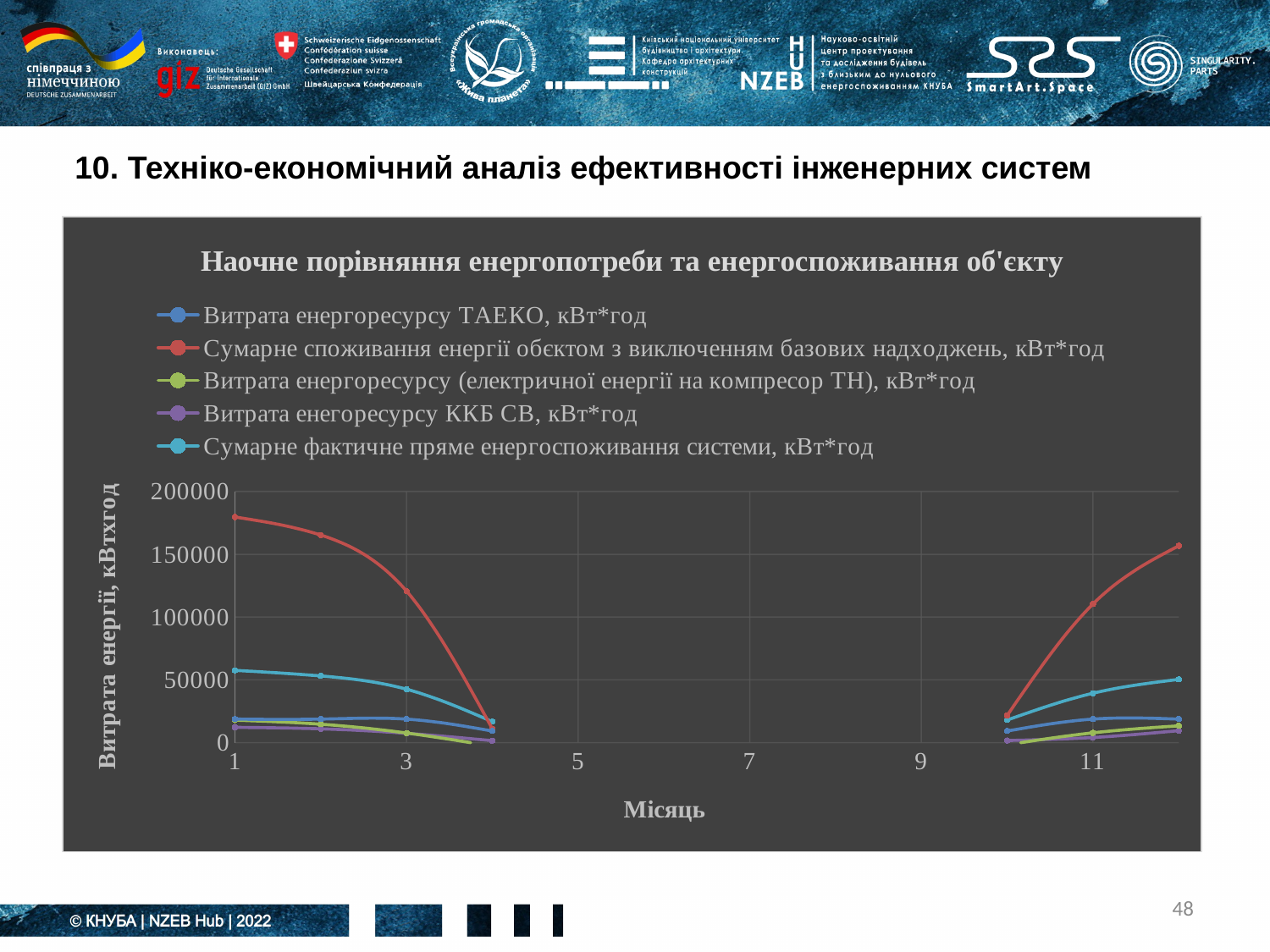
What is the label of the horizontal axis of the chart? Місяць Is the value of the series 'Сумарне фактичне пряме енергоспоживання системи' at month 1 greater or less than 100000? less Does the series 'Сумарне споживання енергії обєктом з виключенням базових надходжень' rise or fall from month 1 to month 4? fall Is the value of the series 'Сумарне споживання енергії обєктом з виключенням базових надходжень' at month 4 greater or less than 50000? less What is the title of the chart? Наочне порівняння енергопотреби та енергоспоживання об'єкту Which series has the highest value at month 1? Сумарне споживання енергії обєктом з виключенням базових надходжень, кВт*год What kind of chart is shown on the slide? line chart Is the value of the series 'Сумарне споживання енергії обєктом з виключенням базових надходжень' at month 1 greater or less than 150000? greater How many series does the legend of the chart list? 5 Does the series 'Сумарне споживання енергії обєктом з виключенням базових надходжень' rise or fall from month 10 to month 12? rise